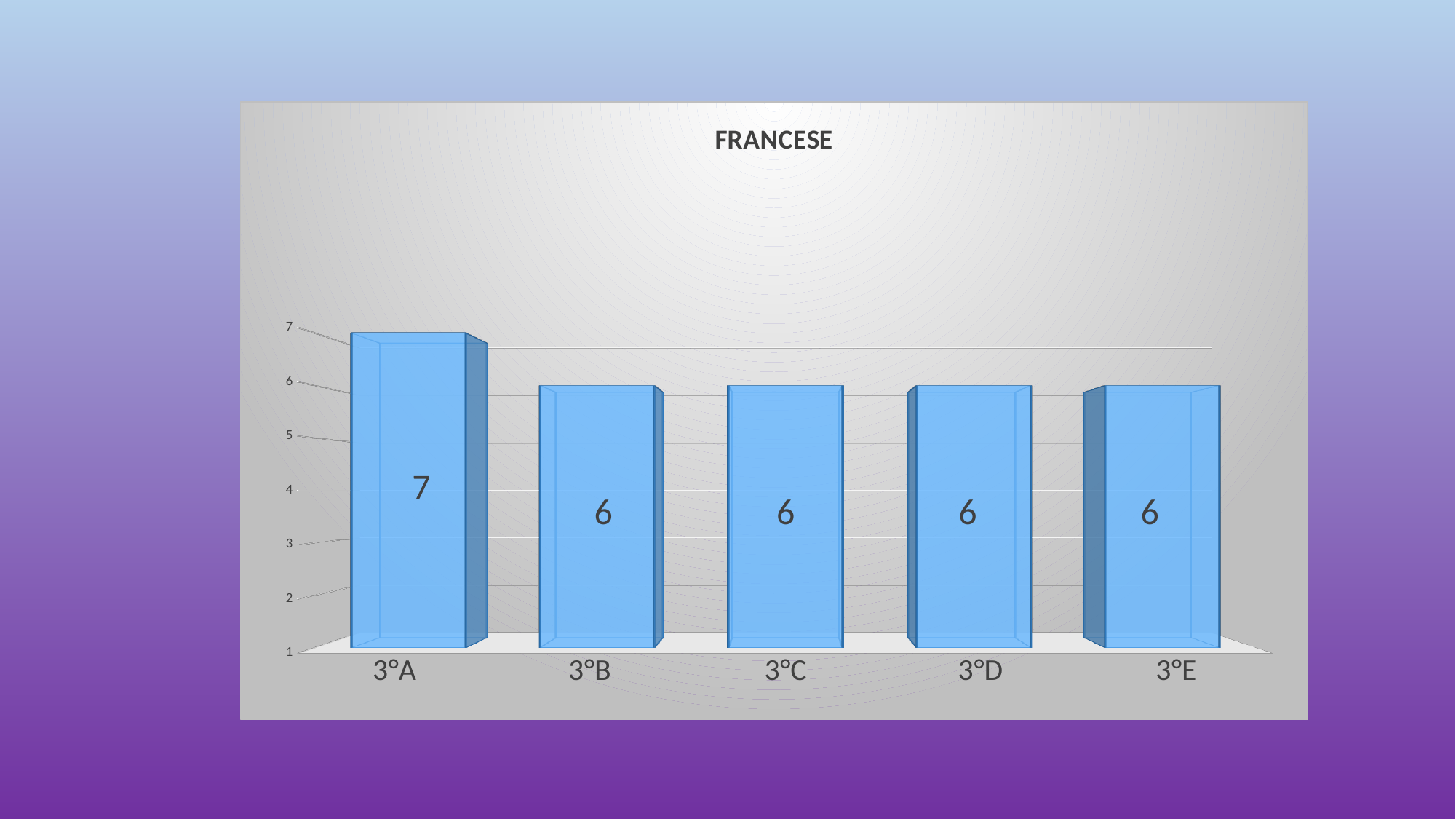
Is the value for 3°B greater or less than 5? greater What is the value for 3°E? 6 What is the difference between the values for 3°A and 3°B? 1 What colour are the bars? blue How many categories have a value of 6? 4 What is the value for 3°A? 7 Which category has the highest value? 3°A How many categories are shown on the x axis? 5 Which is larger, the value for 3°A or the value for 3°D? 3°A What is the value for 3°C? 6 What kind of chart is shown? bar chart What is the title of the chart? FRANCESE